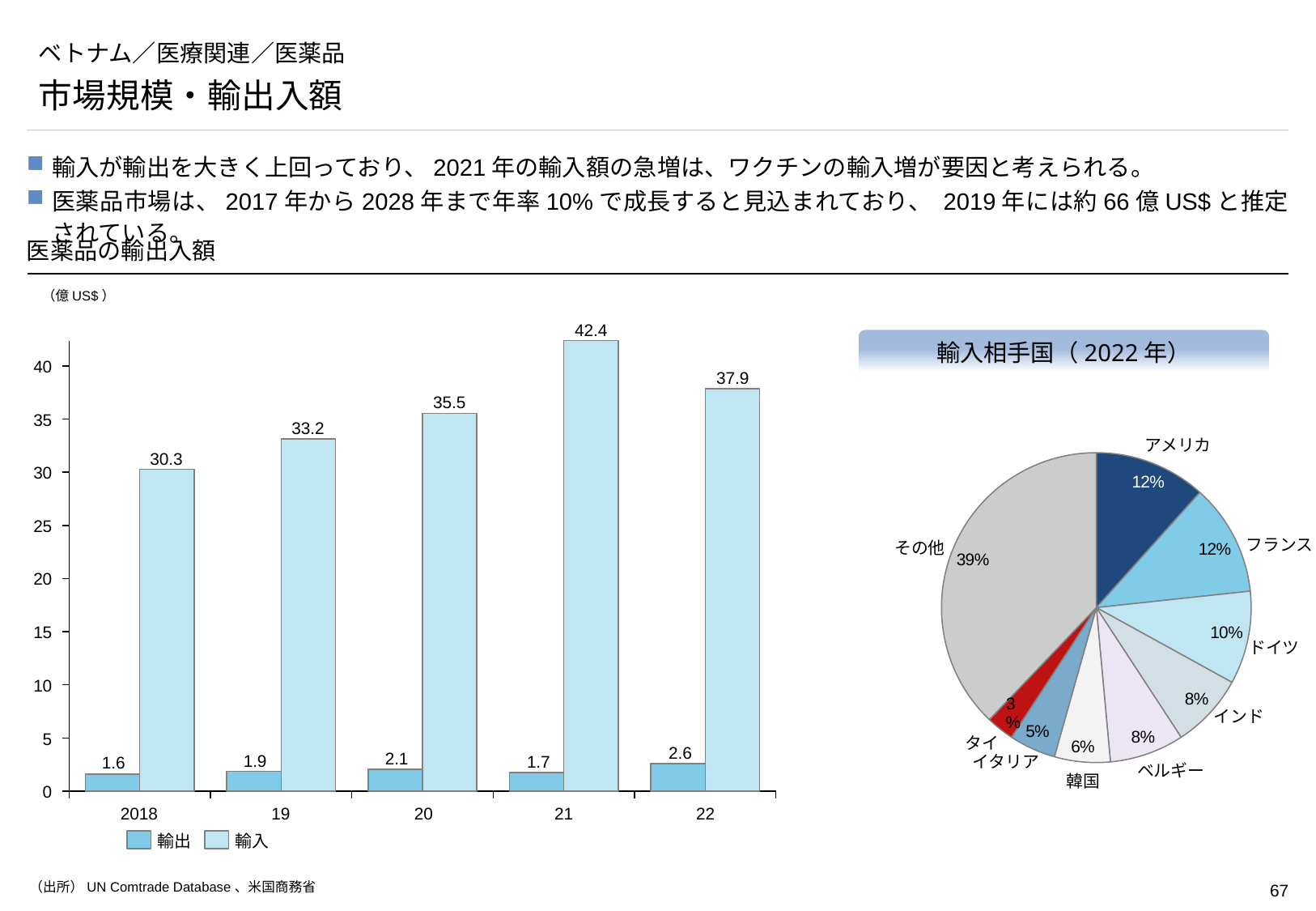
In the bar chart 医薬品の輸出入額, what is the 輸出 value for 2018? 1.6 In the pie chart 輸入相手国 (2022年), which slice is the largest? その他 In the bar chart 医薬品の輸出入額, how many years are shown on the x axis? 5 In the pie chart 輸入相手国 (2022年), which is larger, the share for インド or the share for 韓国? インド In the bar chart 医薬品の輸出入額, which year has the lowest 輸出 value? 2018 In the bar chart 医薬品の輸出入額, which year has the highest 輸入 value? 21 In the bar chart 医薬品の輸出入額, what is the difference between the 輸入 values for 2021 and 2022? 4.5 In the bar chart 医薬品の輸出入額, is the 輸入 value for 2019 greater or less than 30? greater In the bar chart 医薬品の輸出入額, how many series does the legend list? 2 In the pie chart 輸入相手国 (2022年), what share does ドイツ have? 10% What kind of chart is 輸入相手国 (2022年)? pie chart In the bar chart 医薬品の輸出入額, what is the 輸入 value for 2021? 42.4